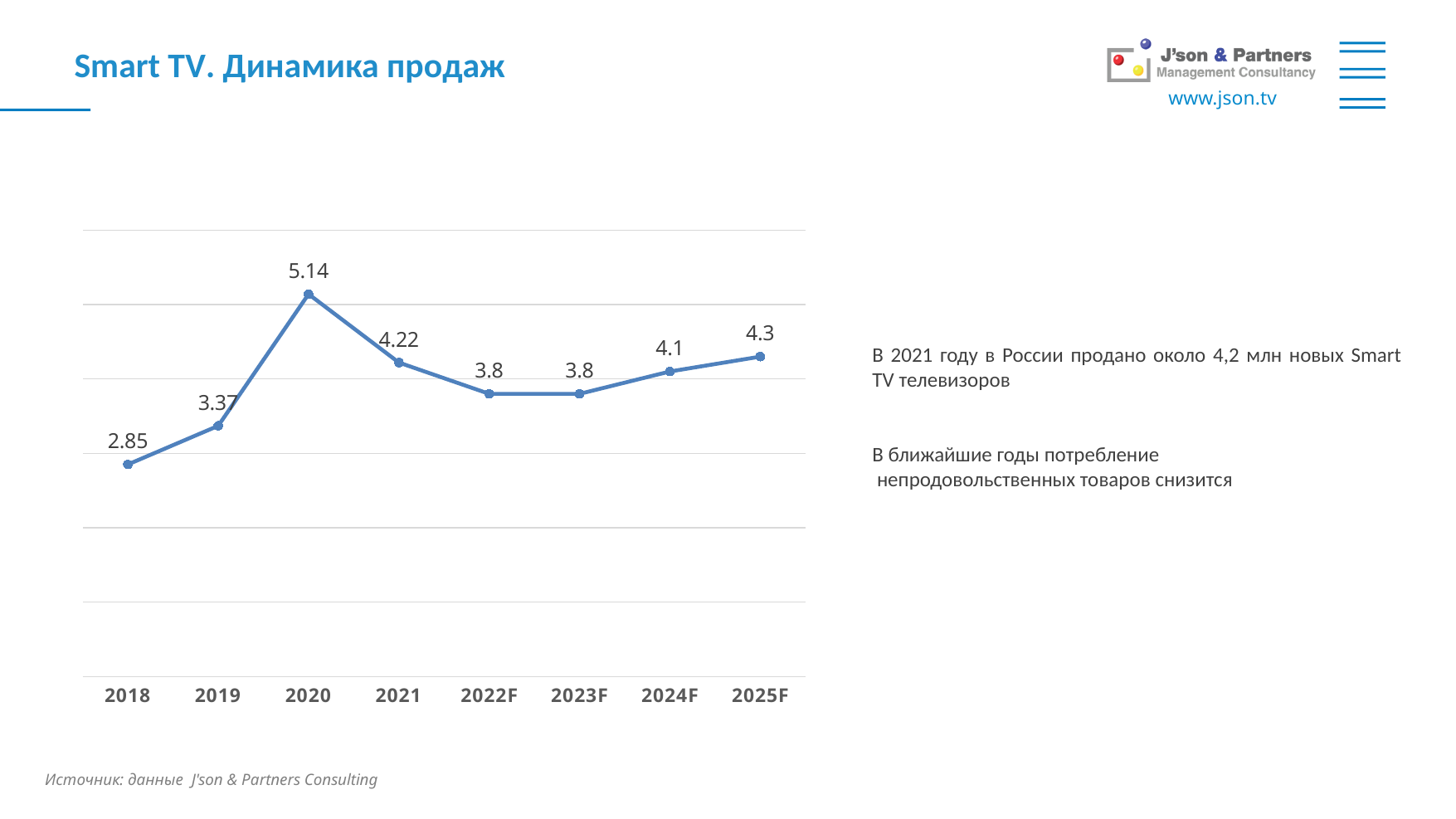
What is the difference between the values for 2020 and 2021? 0.92 What is the value for 2018? 2.85 What is the value for 2020? 5.14 Which is larger, the value for 2019 or the value for 2024F? 2024F Which year has the highest value? 2020 What is the value for 2021? 4.22 What is the title of the slide containing the chart? Smart TV. Динамика продаж Do the values rise or fall from 2023F to 2025F? Rise What kind of chart is shown on the slide? Line chart Which year has the lowest value? 2018 What is the value for 2025F? 4.3 How many data points are plotted on the chart? 8